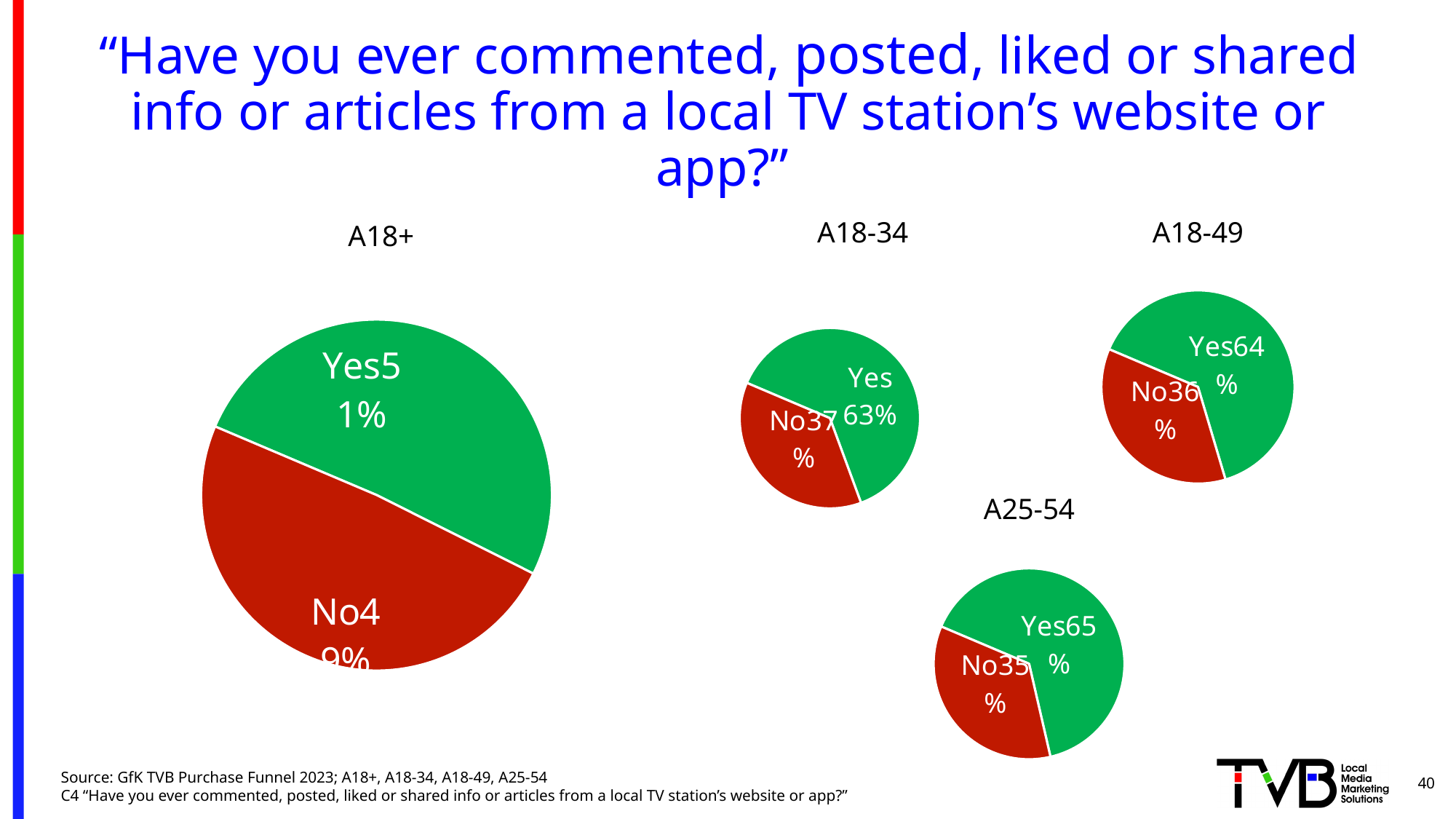
In the A18+ pie chart, what percentage answered Yes? 51% In the A25-54 pie chart, what is the difference between the Yes and No percentages? 30% In the A18-49 pie chart, what is the difference between the Yes and No percentages? 28% Which age group's pie chart shows the highest Yes percentage? A25-54 What kind of charts are shown on the slide? Pie charts How many pie charts are on the slide? 4 In the A18-34 pie chart, what percentage answered No? 37% In the A25-54 pie chart, what percentage answered Yes? 65% In the A18-34 pie chart, which slice is larger, Yes or No? Yes In the pie charts, what colour represents the Yes responses? Green In the A25-54 pie chart, what percentage answered No? 35% In the A18-49 pie chart, what percentage answered Yes? 64%